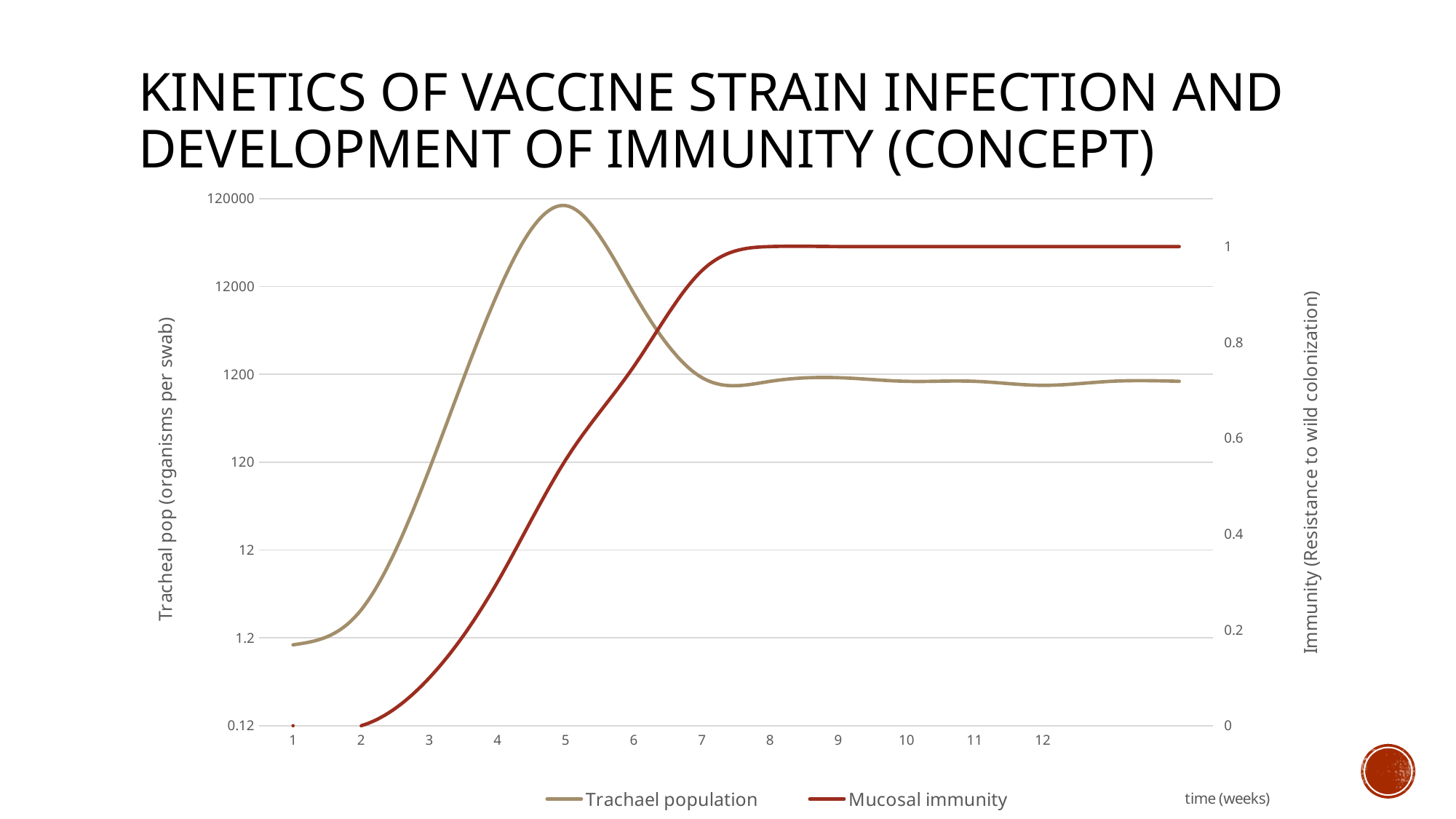
Is the Mucosal immunity at week 5 greater or less than 0.8? less Is the Trachael population at week 1 greater or less than 12? less What kind of chart is shown on the slide? Line chart How does the Mucosal immunity change over time along the x axis? It rises and then levels off What is the title of the left vertical axis? Tracheal pop (organisms per swab) How many week labels are shown on the x axis? 12 What is the Mucosal immunity value at week 2? 0 How many series does the legend list? 2 At which week does the Trachael population reach its highest value? Week 5 Is the Trachael population at week 10 greater or less than 12000? less